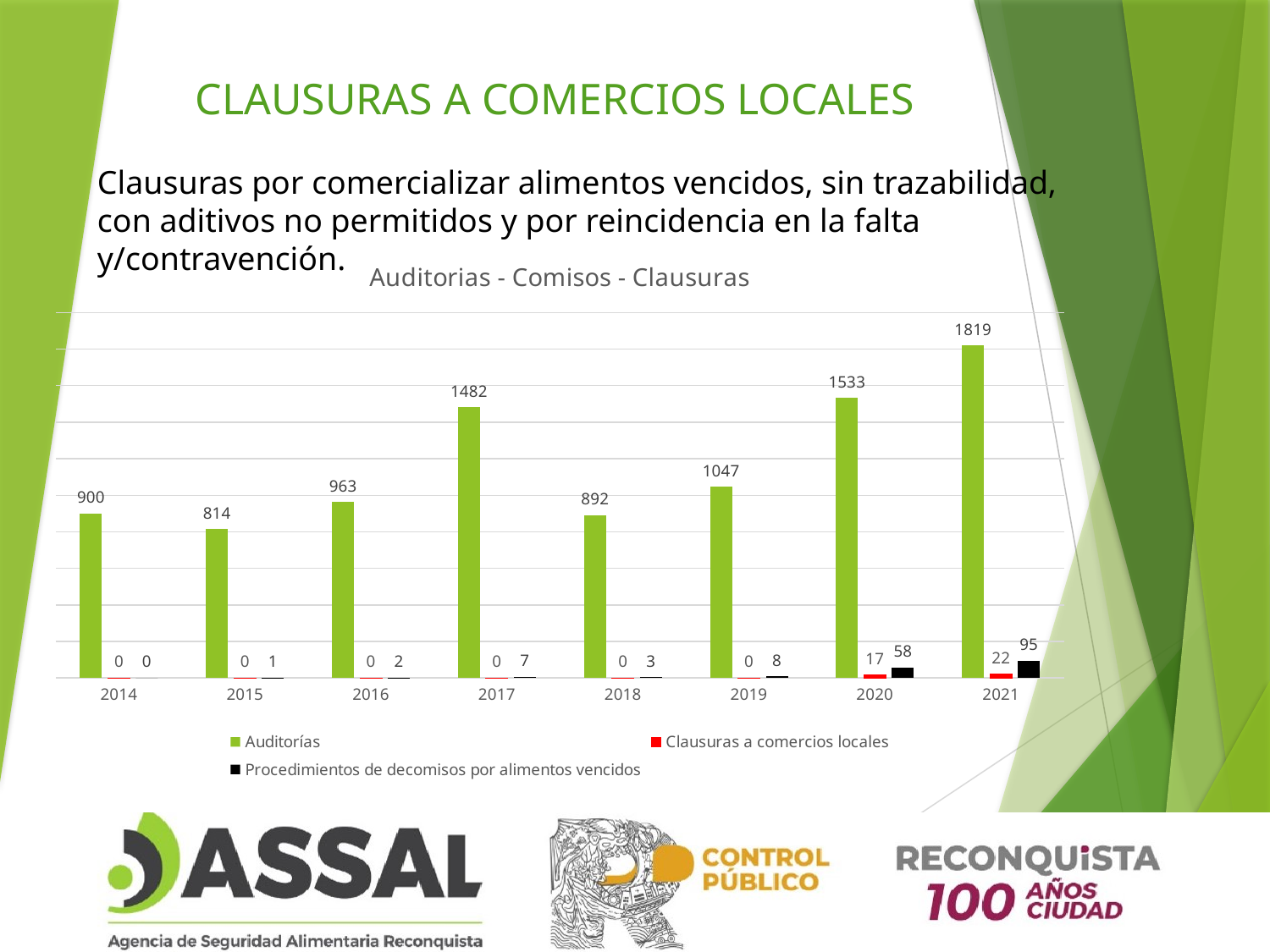
Which is larger, the Auditorías value for 2016 or for 2018? 2016 How many series does the legend list? 3 Which year has the highest value for Auditorías? 2021 What is the value for Auditorías in 2017? 1482 How many years are shown on the x axis? 8 What is the value for Clausuras a comercios locales in 2021? 22 What is the value for Procedimientos de decomisos por alimentos vencidos in 2020? 58 What kind of chart is shown on the slide? bar chart What is the title of the chart? Auditorias - Comisos - Clausuras What is the value for Auditorías in 2021? 1819 Which year has the lowest value for Auditorías? 2015 What is the difference between the Auditorías values for 2021 and 2020? 286